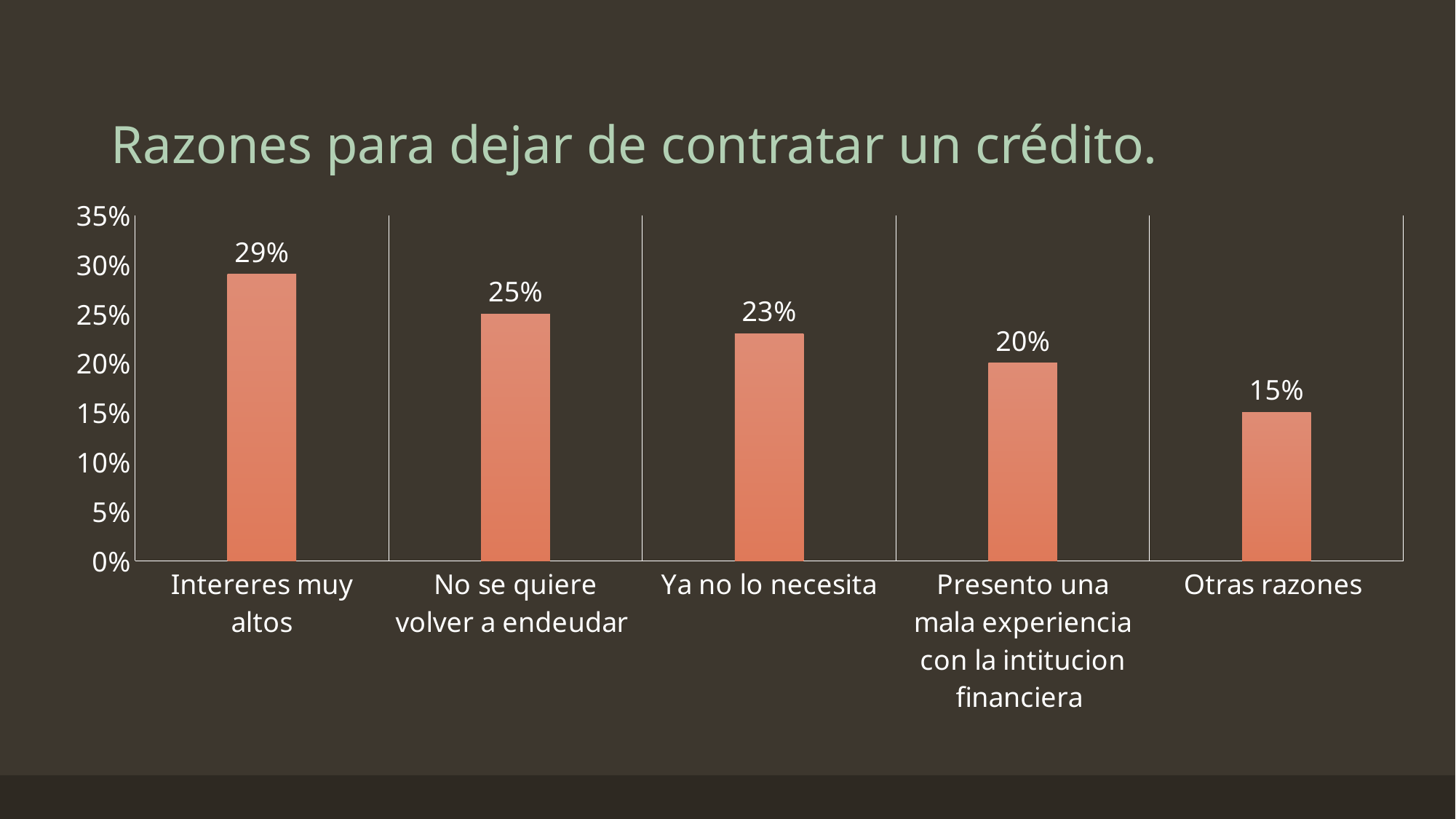
What is the value for "Intereres muy altos"? 29% What is the value for "Otras razones"? 15% What is the value for "Ya no lo necesita"? 23% Is the value for "Presento una mala experiencia con la intitucion financiera" greater or less than 25%? less What is the difference between "Presento una mala experiencia con la intitucion financiera" and "Otras razones"? 5% How many categories are shown in the chart? 5 What is the difference between "Intereres muy altos" and "No se quiere volver a endeudar"? 4% Which category has the highest value? Intereres muy altos Do the values rise or fall from left to right along the x axis? fall Which category has the lowest value? Otras razones What kind of chart is shown on the slide? bar chart Which is larger, "No se quiere volver a endeudar" or "Ya no lo necesita"? No se quiere volver a endeudar